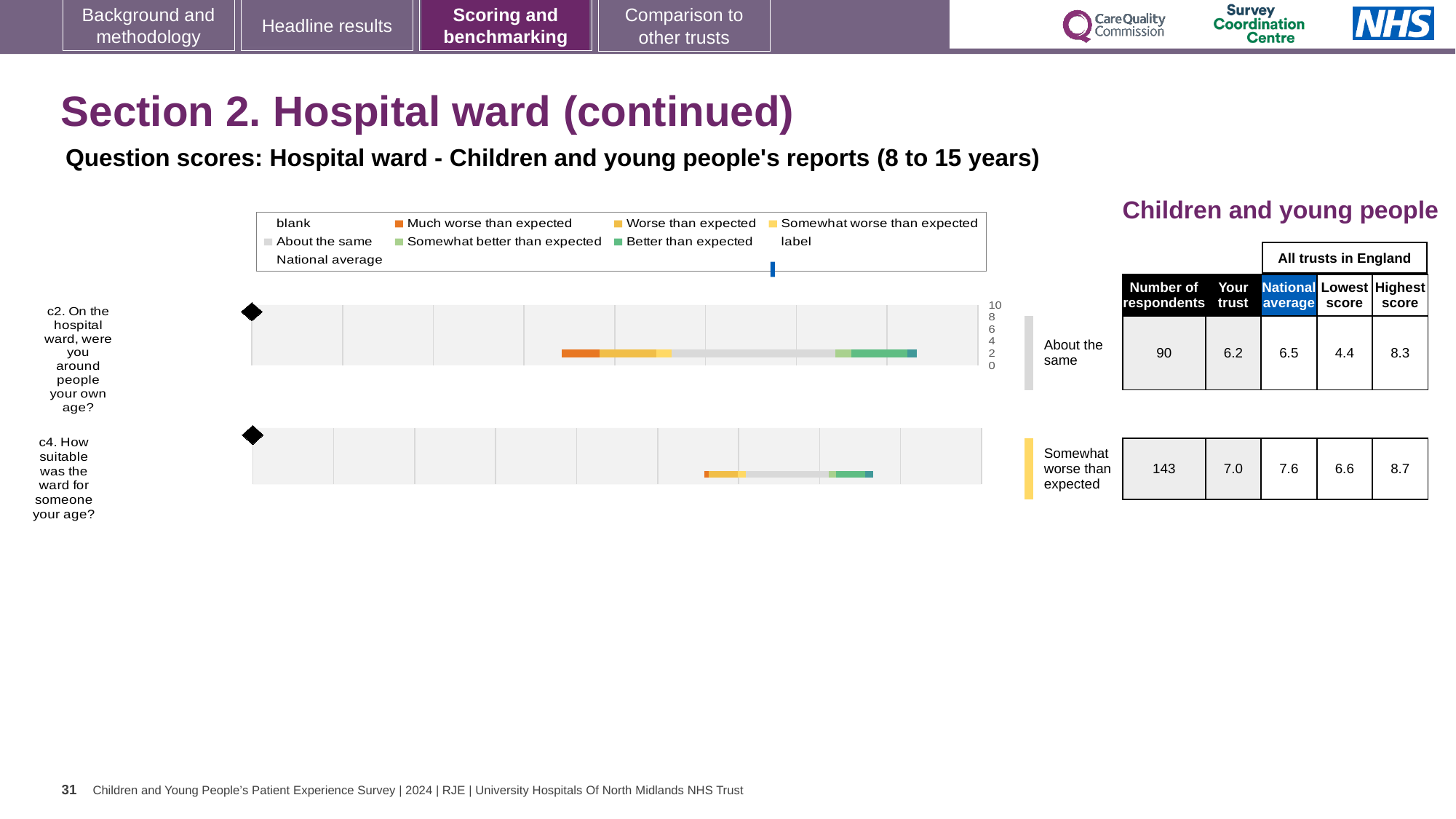
What is the national average score for question c4? 7.6 What kind of chart is used to show the question scores for c2 and c4? bar chart What is the maximum value shown on the score axis of the charts? 10 Which question has the higher 'Your trust' score, c2 or c4? c4 What is the 'Your trust' score for question c4 (How suitable was the ward for someone your age?)? 7.0 What is the difference between the highest and lowest scores across all trusts in England for question c2? 3.9 What is the difference between the national average and the trust score for question c4? 0.6 How many respondents answered question c4? 143 How many questions (categories) are plotted on the slide? 2 What is the national average score for question c2? 6.5 What is the 'Your trust' score for question c2 (On the hospital ward, were you around people your own age?)? 6.2 What benchmark category is question c4 placed in? Somewhat worse than expected